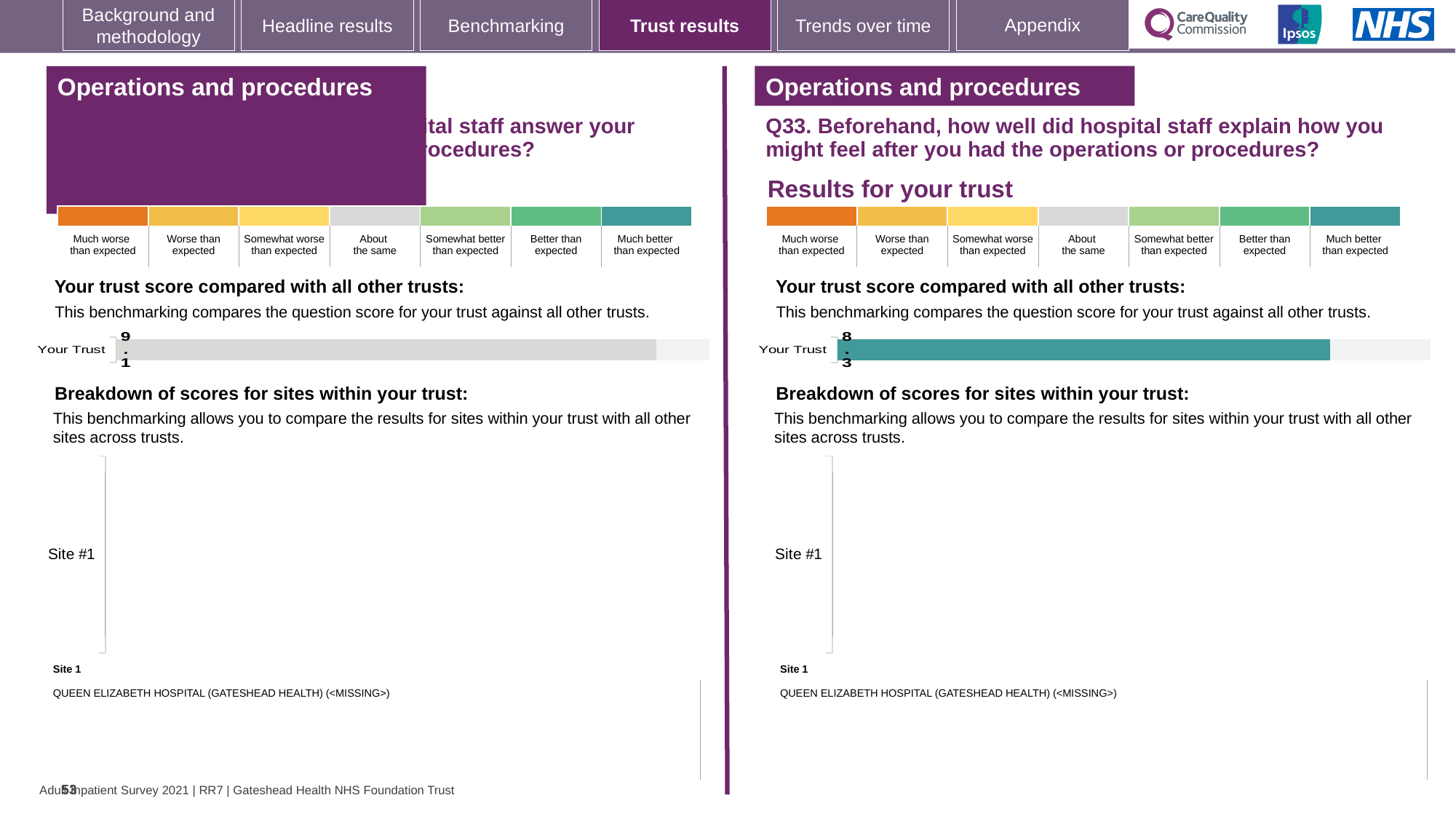
What is the category label on the bar in the left-hand trust score chart? Your Trust How many categories are plotted in the 'Your trust score compared with all other trusts' chart on the right (Q33)? 1 What kind of chart is used to show the Your Trust score in the right-hand (Q33) panel? Bar chart In the 'Your trust score compared with all other trusts' chart on the left side of the slide, what is the score shown for Your Trust? 9.1 Which trust score is larger: the one in the left-hand chart or the one in the right-hand (Q33) chart? The left-hand chart (9.1) What colour is the Your Trust bar in the right-hand (Q33) trust score chart? Teal What is the difference between the Your Trust score in the left-hand chart and the Your Trust score in the right-hand (Q33) chart? 0.8 In the 'Your trust score compared with all other trusts' chart on the right (Q33), what is the score shown for Your Trust? 8.3